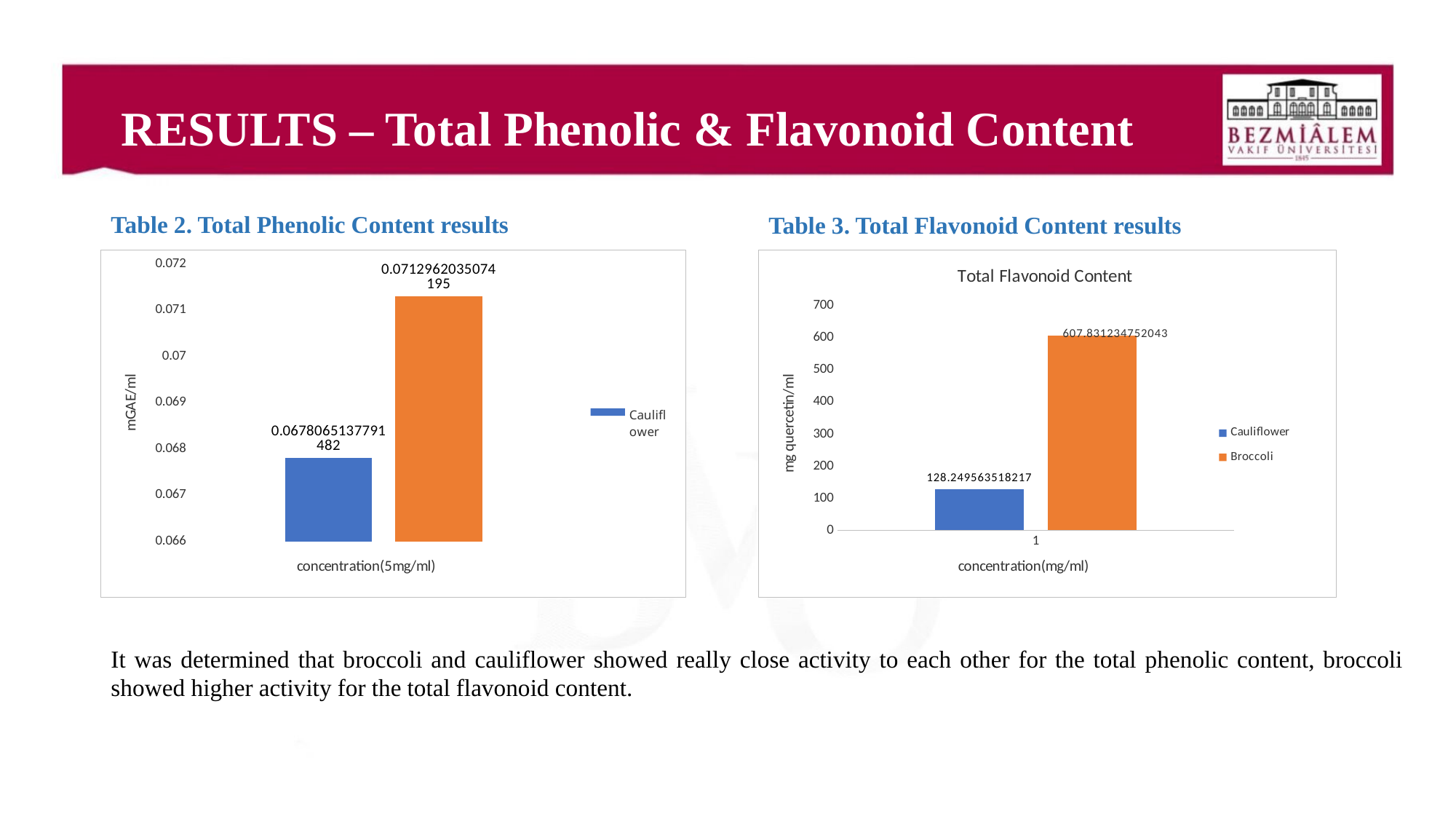
How many series does the legend of the Total Flavonoid Content chart list? 2 In the Total Flavonoid Content chart, is the value for Cauliflower greater or less than 200? less What is the y-axis label of the Table 2 Total Phenolic Content chart? mGAE/ml In the Total Flavonoid Content chart, what is the value for Cauliflower? 128.249563518217 In the Table 2 Total Phenolic Content chart, what is the value for Cauliflower? 0.0678065137791482 What is the y-axis label of the Total Flavonoid Content chart? mg quercetin/ml In the Total Flavonoid Content chart, what is the difference between the Broccoli and Cauliflower values? 479.581671233826 In the Table 2 Total Phenolic Content chart, is the value for Cauliflower greater or less than 0.068? less In the Total Flavonoid Content chart, what is the value for Broccoli? 607.831234752043 In the Total Flavonoid Content chart, which series has the higher value, Cauliflower or Broccoli? Broccoli What kind of chart is the Total Flavonoid Content chart? bar chart In the Table 2 Total Phenolic Content chart, what is the value shown on the orange bar? 0.0712962035074195